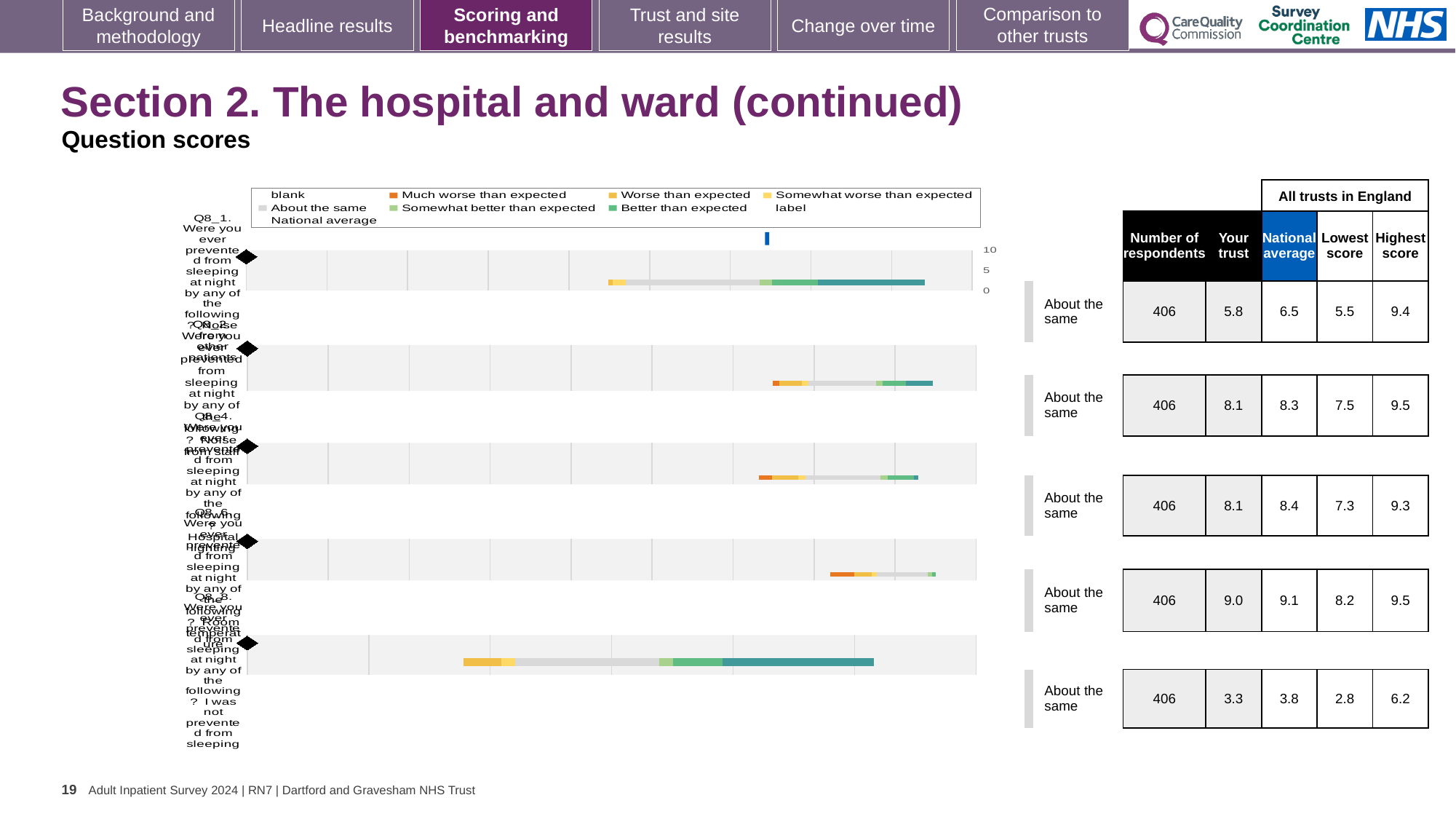
In the table beside the chart, what is the 'Your trust' score in the last (fifth) row? 3.3 What colour represents 'About the same' in the chart legend? grey In the last row of the table, what is the difference between the national average and the 'Your trust' score? 0.5 In the table beside the chart, what is the highest score in the first row? 9.4 In the table beside the chart, which row has the highest 'Your trust' score? the fourth row (9.0) In the table beside the chart, what is the number of respondents shown in the first row? 406 In the table beside the chart, which row has the lowest 'Your trust' score? the fifth row (3.3) What kind of chart is shown on the slide? bar chart In the last row of the table, which is larger: the 'Your trust' score or the national average? National average How many question bars are plotted in the chart? 5 Which legend entry is shown in dark orange? Much worse than expected How many entries does the chart legend list? 9